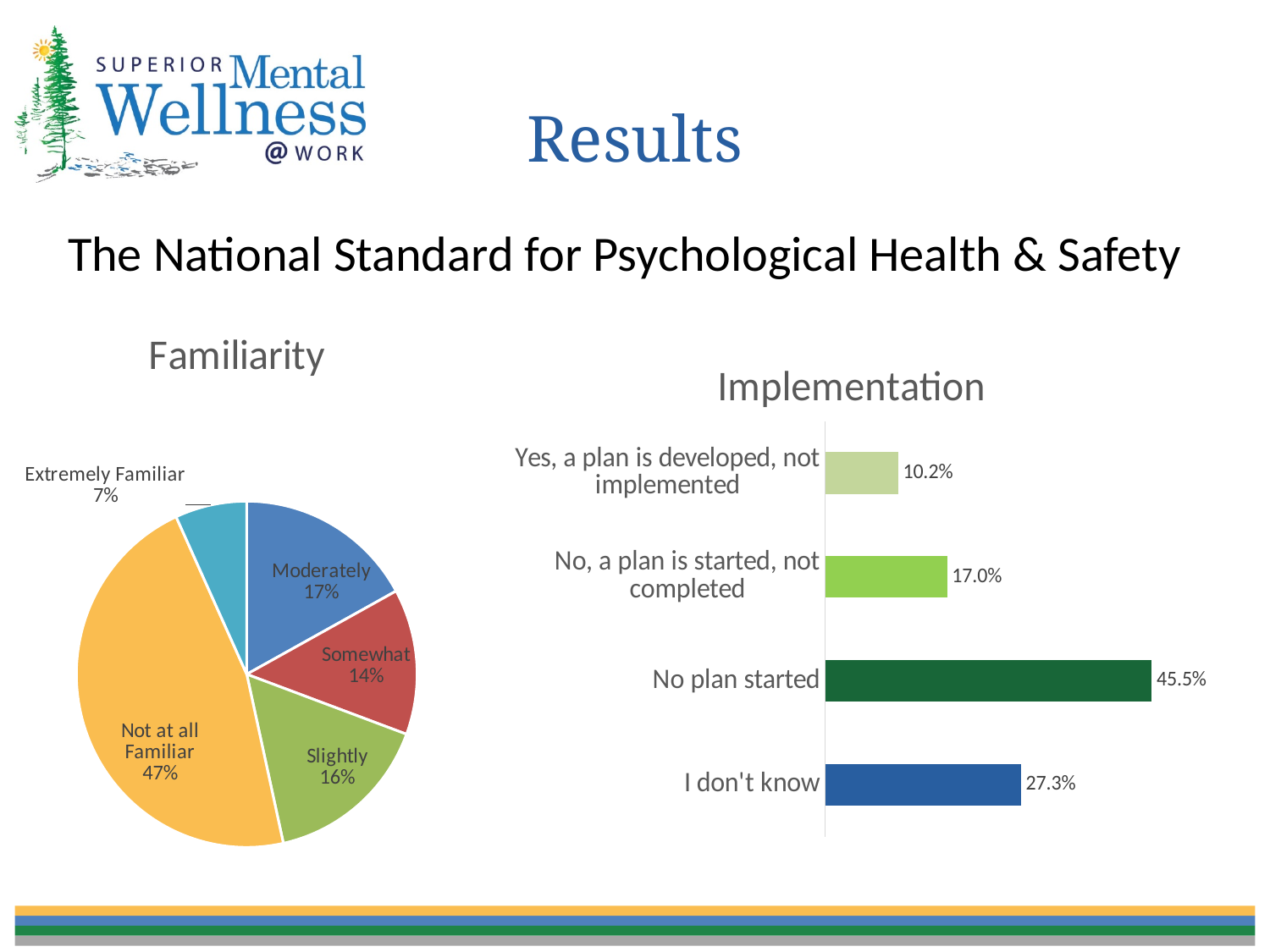
In the Familiarity chart, which category has the largest slice? Not at all Familiar In the Implementation chart, what is the value for No plan started? 45.5% What kind of chart is the Implementation chart? Bar chart In the Implementation chart, which category has the lowest value? Yes, a plan is developed, not implemented In the Implementation chart, what is the value for 'Yes, a plan is developed, not implemented'? 10.2% In the Familiarity chart, how many categories are shown? 5 In the Implementation chart, what is the difference between No plan started and I don't know? 18.2% In the Familiarity chart, what percentage are Extremely Familiar? 7% What kind of chart is the Familiarity chart? Pie chart In the Familiarity chart, what share of respondents are Not at all Familiar? 47% In the Familiarity chart, which category has the smallest slice? Extremely Familiar In the Familiarity chart, what is the difference between the Moderately and Somewhat shares? 3%